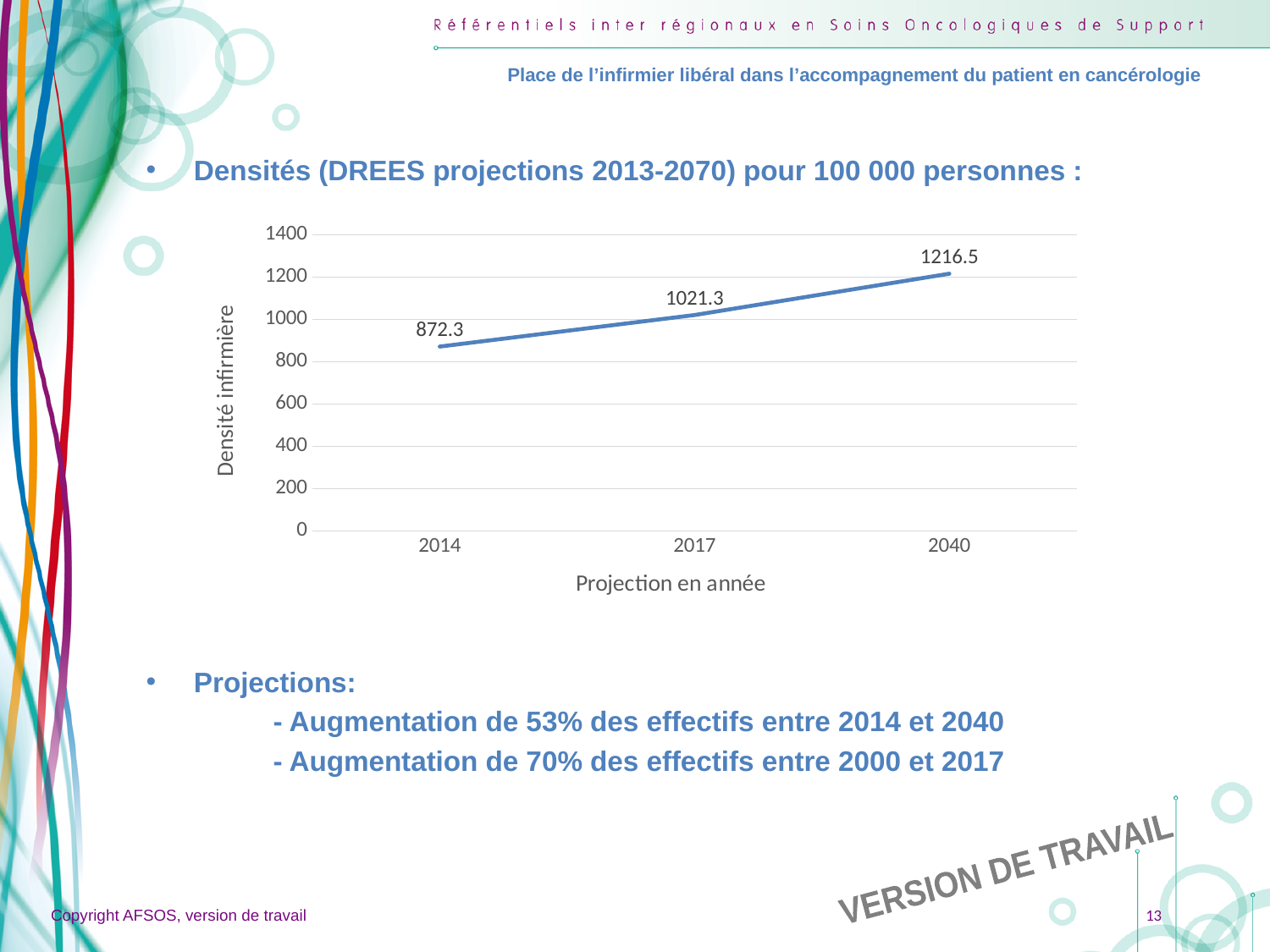
What type of chart is shown on the slide? line chart How many data points are plotted on the line? 3 What is the nurse density value plotted for 2040? 1216.5 Which year has the highest plotted density value? 2040 Is the value for 2014 greater or less than 1000? less Which year has the lowest plotted density value? 2014 What is the nurse density value plotted for 2014? 872.3 What is the nurse density value plotted for 2017? 1021.3 What is the difference between the values for 2040 and 2014? 344.2 Do the values rise or fall from 2014 to 2040 along the x axis? rise Which is larger, the value for 2017 or the value for 2040? 2040 What is the difference between the values for 2017 and 2014? 149